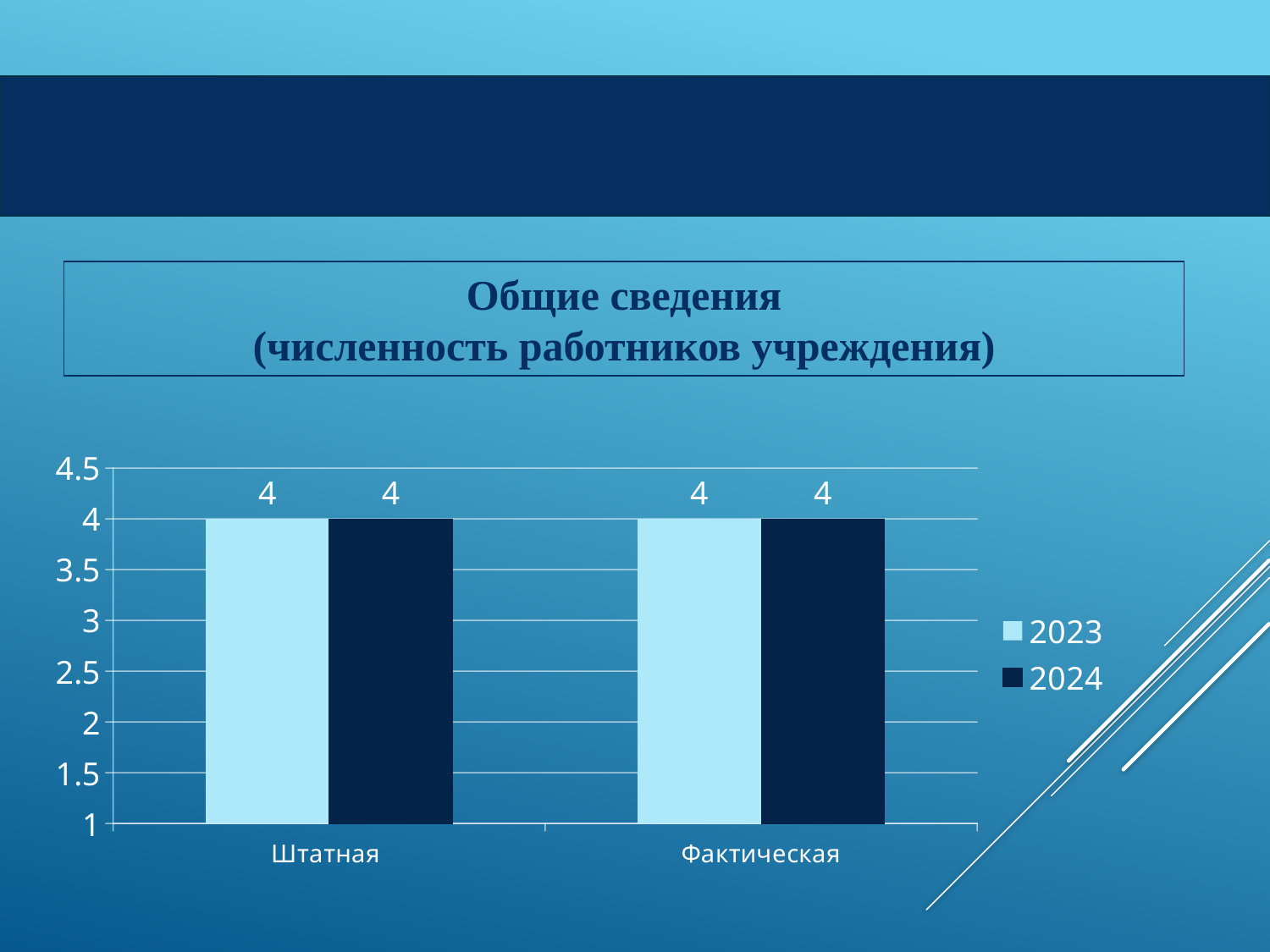
What is the difference between the Штатная and Фактическая values in 2024? 0 Which series is shown in dark navy in the legend? 2024 What is the value for Штатная in 2024? 4 How many categories are shown on the x axis? 2 What is the difference between the 2023 and 2024 values for Штатная? 0 Is the value for Штатная in 2023 greater or less than 3? greater What is the value for Фактическая in 2024? 4 What kind of chart is shown on the slide? bar chart What is the title shown above the chart? Общие сведения (численность работников учреждения) What is the value for Штатная in 2023? 4 What is the value for Фактическая in 2023? 4 How many series does the legend list? 2